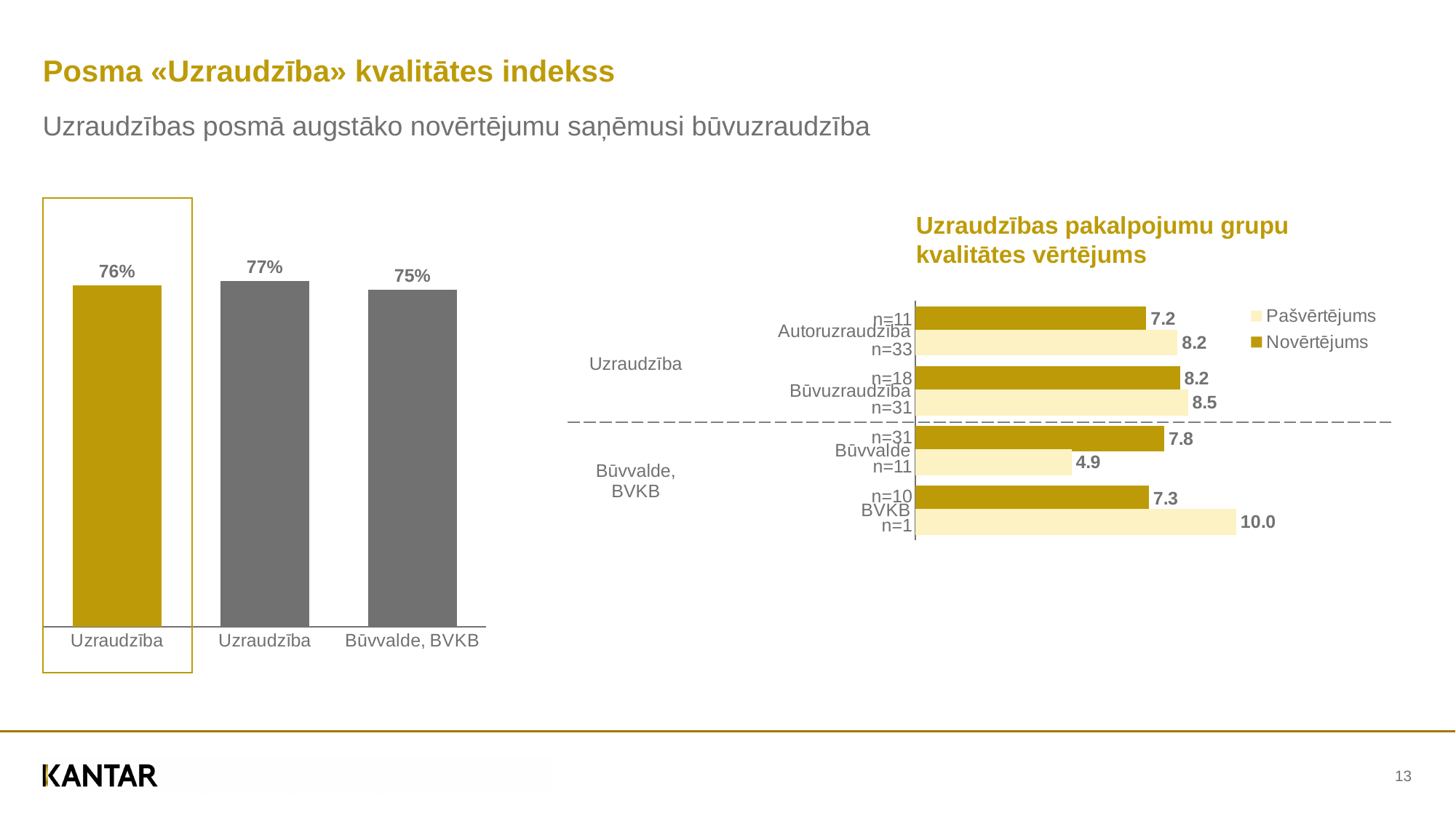
What type of chart is the left-hand chart? Bar chart In the left-hand chart, what is the value of the bar for Būvvalde, BVKB? 75% In the right-hand chart, what is the Pašvērtējums value for BVKB? 10.0 How many categories are shown in the right-hand chart? 4 In the right-hand chart, which category has the highest Novērtējums value? Būvuzraudzība In the right-hand chart, what is the Pašvērtējums value for Būvvalde? 4.9 In the right-hand chart 'Uzraudzības pakalpojumu grupu kvalitātes vērtējums', what is the Novērtējums value for Būvuzraudzība? 8.2 In the right-hand chart, what is the Novērtējums value for Autoruzraudzība? 7.2 In the right-hand chart, which is larger for BVKB: the Pašvērtējums or the Novērtējums value? Pašvērtējums In the right-hand chart, what is the difference between the Pašvērtējums and Novērtējums values for Būvvalde? 2.9 In the right-hand chart, which category has the lowest Pašvērtējums value? Būvvalde How many series does the legend of the right-hand chart list? 2